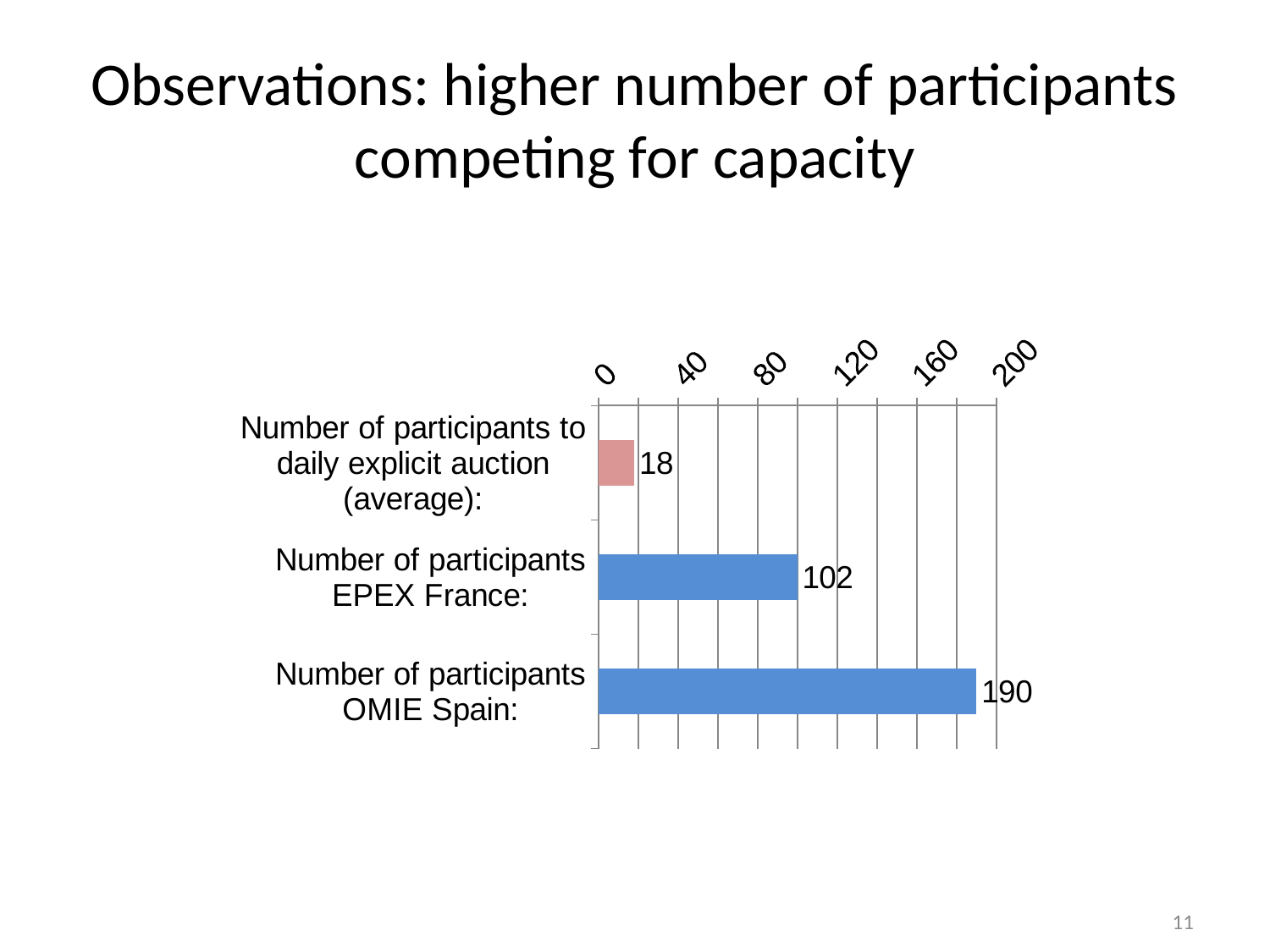
Which is larger: the number of participants EPEX France or the number of participants to daily explicit auction (average)? Number of participants EPEX France How many categories are shown in the chart? 3 What is the number of participants to daily explicit auction (average)? 18 What is the number of participants EPEX France? 102 What kind of chart is shown on the slide? Bar chart Which category has the highest value? Number of participants OMIE Spain Is the value for number of participants EPEX France greater or less than 80? greater What is the difference between the number of participants OMIE Spain and the number of participants EPEX France? 88 What is the number of participants OMIE Spain? 190 What is the difference between the number of participants EPEX France and the number of participants to daily explicit auction (average)? 84 What colour is the bar for the number of participants to daily explicit auction (average)? Pink Which category has the lowest value? Number of participants to daily explicit auction (average)